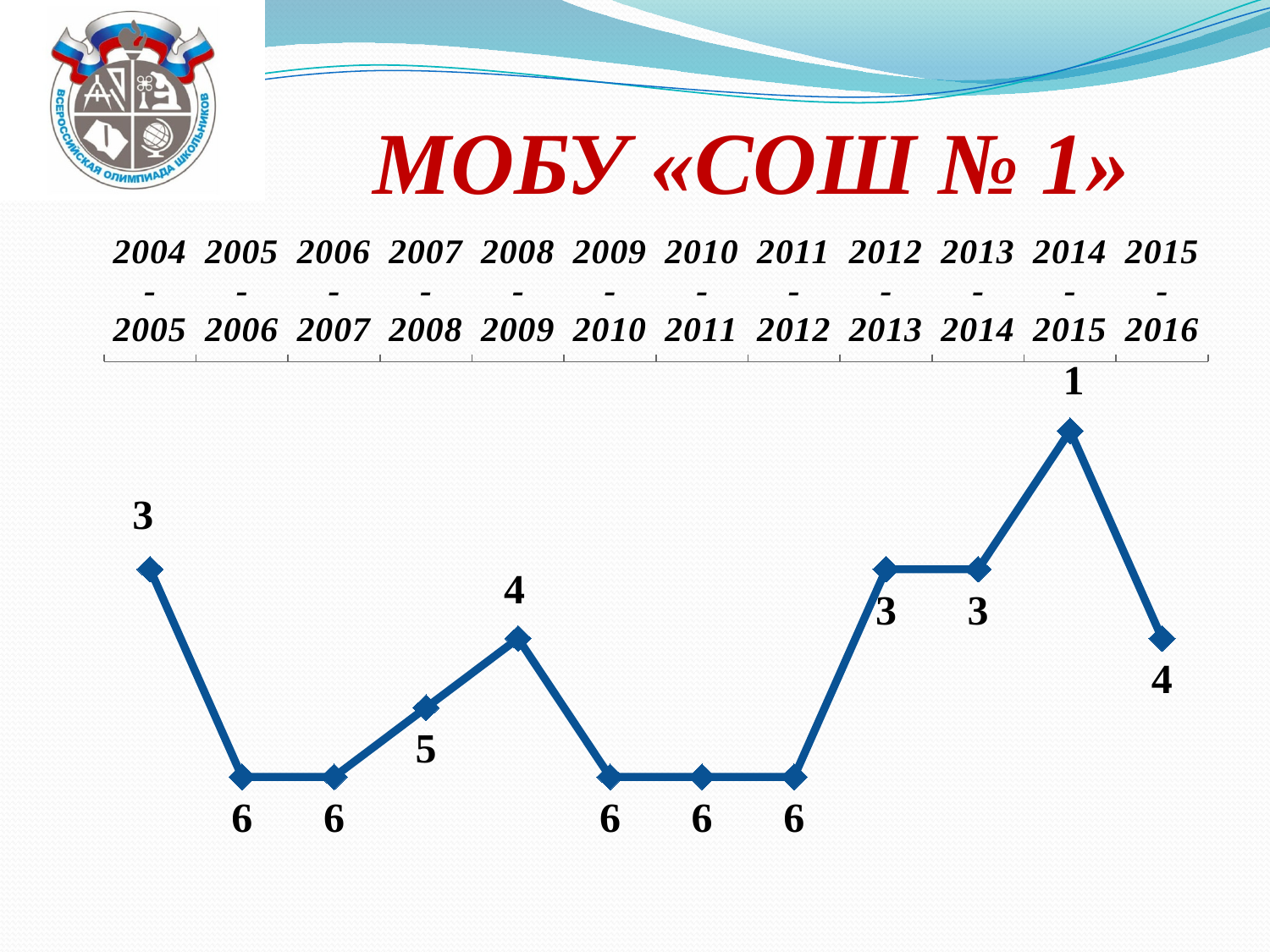
Which period has the lowest value? 2014-2015 What is the difference between the values for 2005-2006 and 2014-2015? 5 What is the value for 2007-2008? 5 What is the title of the slide? МОБУ «СОШ № 1» What is the value for 2014-2015? 1 What is the value for 2004-2005? 3 Which is larger, the value for 2004-2005 or the value for 2005-2006? 2005-2006 What kind of chart is shown on the slide? line chart How many data points are plotted on the chart? 12 What is the value for 2008-2009? 4 What is the difference between the values for 2007-2008 and 2008-2009? 1 What is the value for 2015-2016? 4